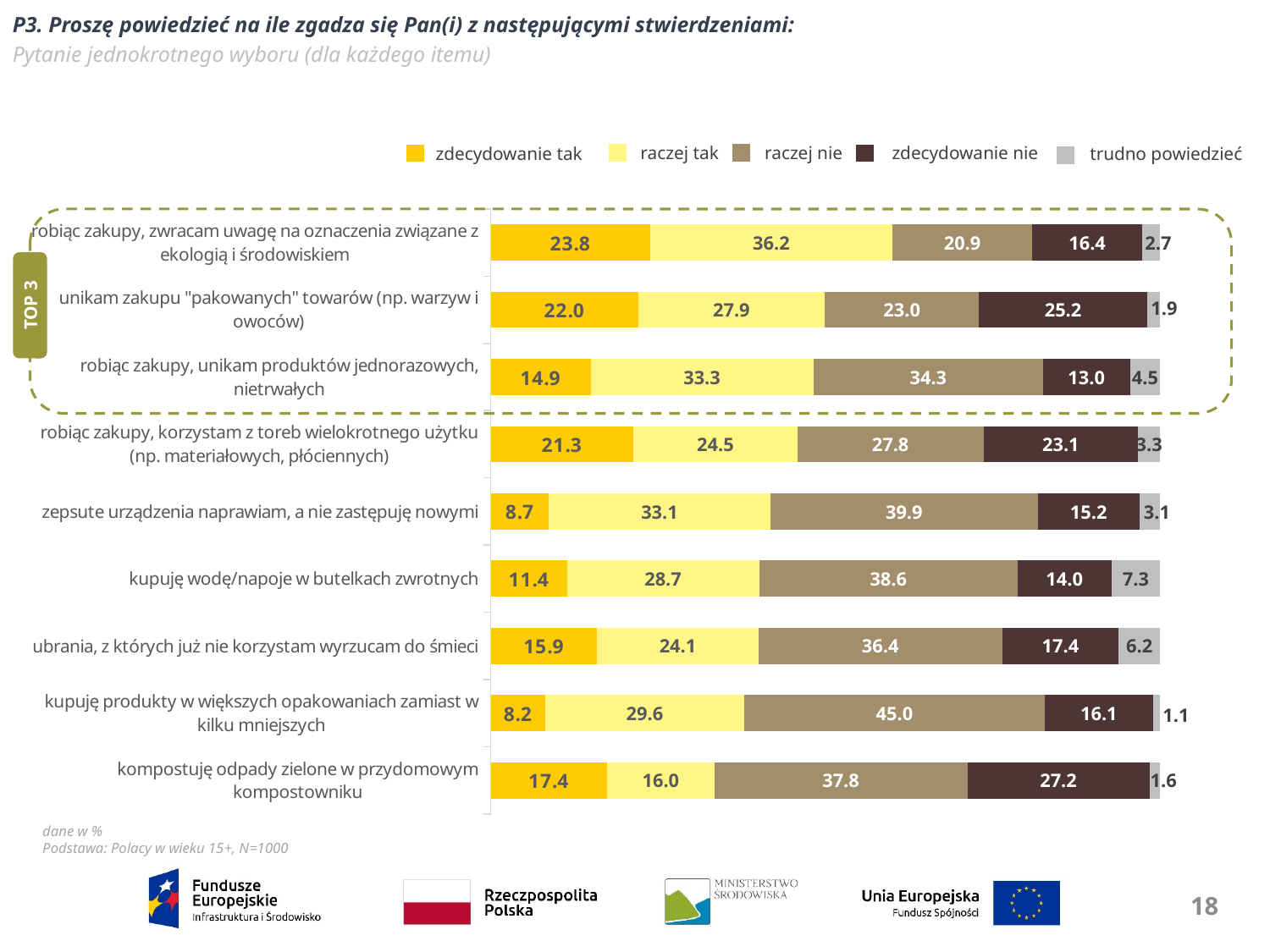
What is the "raczej nie" value for "kupuję produkty w większych opakowaniach zamiast w kilku mniejszych"? 45.0 How many statements (categories) are plotted in the chart? 9 What is the "trudno powiedzieć" value for "robiąc zakupy, unikam produktów jednorazowych, nietrwałych"? 4.5 Which statement has the highest "trudno powiedzieć" value? kupuję wodę/napoje w butelkach zwrotnych Which has the larger "zdecydowanie nie" value: "kompostuję odpady zielone w przydomowym kompostowniku" or "ubrania, z których już nie korzystam wyrzucam do śmieci"? kompostuję odpady zielone w przydomowym kompostowniku What kind of chart is shown on the slide? stacked bar chart Which statement has the highest "zdecydowanie tak" value? robiąc zakupy, zwracam uwagę na oznaczenia związane z ekologią i środowiskiem What is the difference between the "raczej tak" values for "robiąc zakupy, zwracam uwagę na oznaczenia związane z ekologią i środowiskiem" and "unikam zakupu "pakowanych" towarów"? 8.3 What is the "zdecydowanie tak" value for "kupuję wodę/napoje w butelkach zwrotnych"? 11.4 How many series does the legend list? 5 Which statement has the lowest "zdecydowanie tak" value? kupuję produkty w większych opakowaniach zamiast w kilku mniejszych What is the total of the stacked bar for "robiąc zakupy, zwracam uwagę na oznaczenia związane z ekologią i środowiskiem"? 100.0